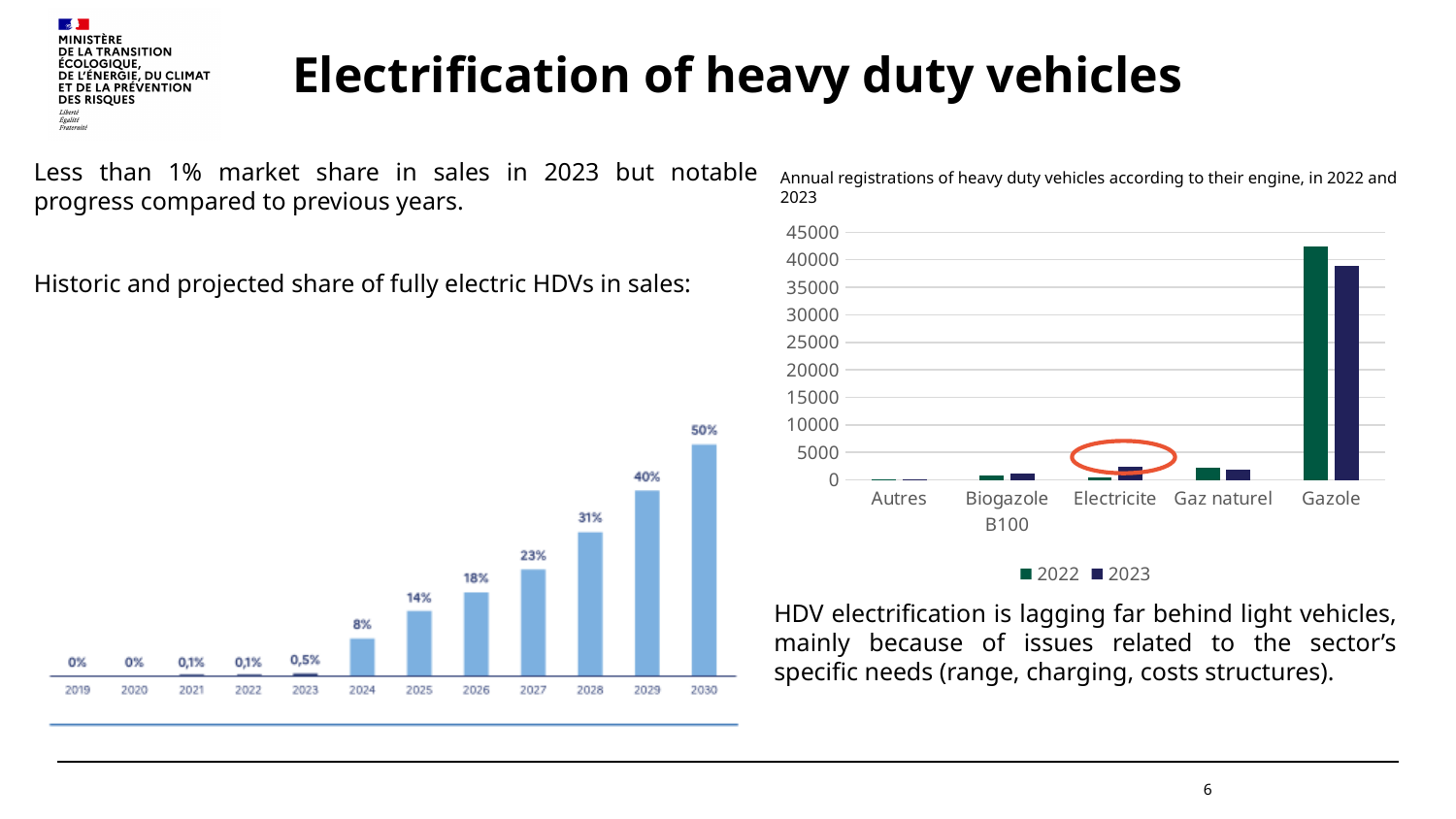
On the left chart (share of fully electric HDVs in sales), what is the value for 2027? 23% On the left chart (share of fully electric HDVs in sales), what is the value for 2030? 50% On the left chart (share of fully electric HDVs in sales), how many years are shown on the x axis? 12 On the right chart (annual registrations of heavy duty vehicles), how many series does the legend list? 2 On the right chart (annual registrations of heavy duty vehicles), is the value for Gazole in 2022 greater or less than 40000? greater What kind of chart is the right chart (annual registrations of heavy duty vehicles)? bar chart On the left chart (share of fully electric HDVs in sales), what is the value for 2023? 0,5% On the left chart (share of fully electric HDVs in sales), which is larger, the value for 2025 or the value for 2026? 2026 On the left chart (share of fully electric HDVs in sales), do the values rise or fall from 2019 to 2030? rise On the left chart (share of fully electric HDVs in sales), which year has the highest value? 2030 On the right chart (annual registrations of heavy duty vehicles), which engine category has the highest registrations in 2022? Gazole On the left chart (share of fully electric HDVs in sales), what is the difference between the values for 2029 and 2028? 9%